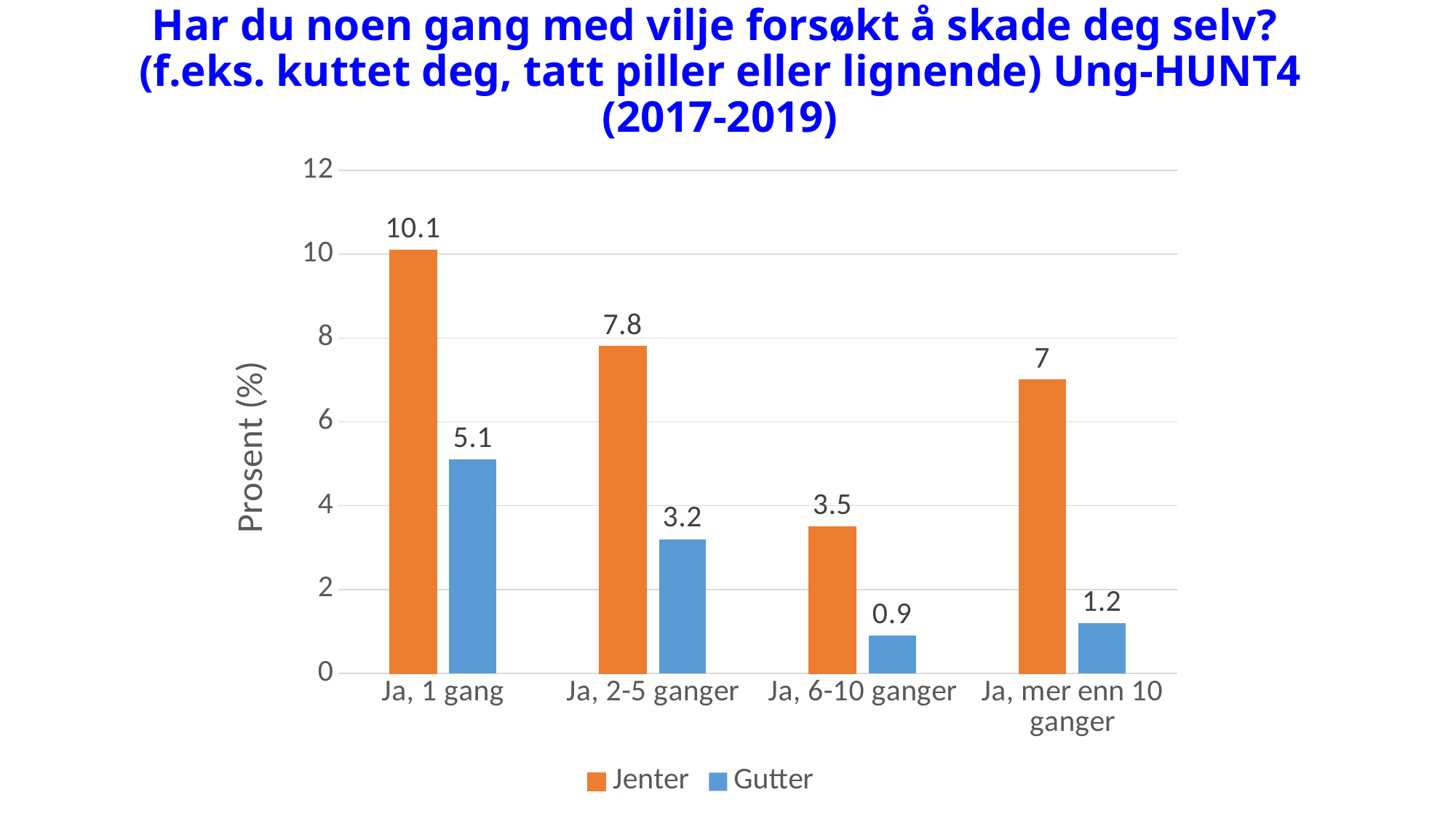
Is the value for Jenter in "Ja, 2-5 ganger" greater or less than 6? greater Which category has the highest value for Gutter? Ja, 1 gang How many categories are shown on the x axis? 4 Which category has the lowest value for Jenter? Ja, 6-10 ganger What is the value for Jenter in the "Ja, 1 gang" category? 10.1 What kind of chart is shown on the slide? bar chart What is the value for Gutter in the "Ja, 6-10 ganger" category? 0.9 How many series does the legend list? 2 Which is larger: Gutter in "Ja, 1 gang" or Jenter in "Ja, 6-10 ganger"? Gutter in "Ja, 1 gang" What is the value for Jenter in the "Ja, mer enn 10 ganger" category? 7 What is the difference between Jenter and Gutter in the "Ja, 2-5 ganger" category? 4.6 What is the label of the y axis? Prosent (%)